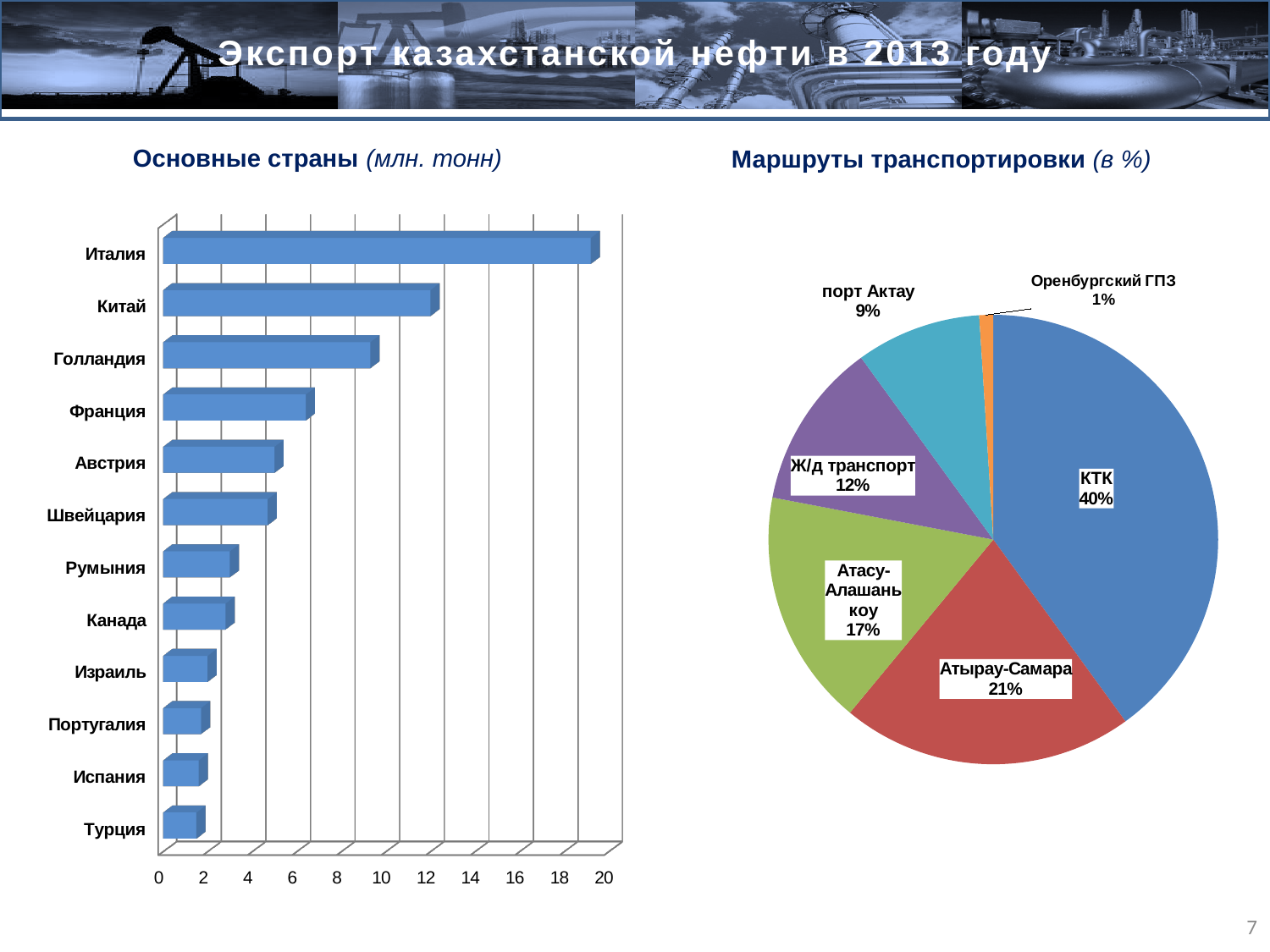
On the pie chart 'Маршруты транспортировки', what share does Атырау-Самара have? 21% On the bar chart 'Основные страны', is the value for Италия greater or less than 18? greater On the pie chart 'Маршруты транспортировки', what share does Ж/д транспорт have? 12% On the pie chart 'Маршруты транспортировки', what is the difference in percentage points between КТК and Атасу-Алашанькоу? 23 On the bar chart 'Основные страны', how many countries are shown? 12 On the bar chart 'Основные страны', which country has the highest value? Италия On the bar chart 'Основные страны', is the value for Франция greater or less than 8? less On the pie chart 'Маршруты транспортировки', how many slices are there? 6 On the bar chart 'Основные страны', which is larger, the value for Китай or the value for Голландия? Китай What type of chart is the left chart 'Основные страны'? Bar chart On the pie chart 'Маршруты транспортировки', which route has the smallest share? Оренбургский ГПЗ On the pie chart 'Маршруты транспортировки', what share does КТК have? 40%